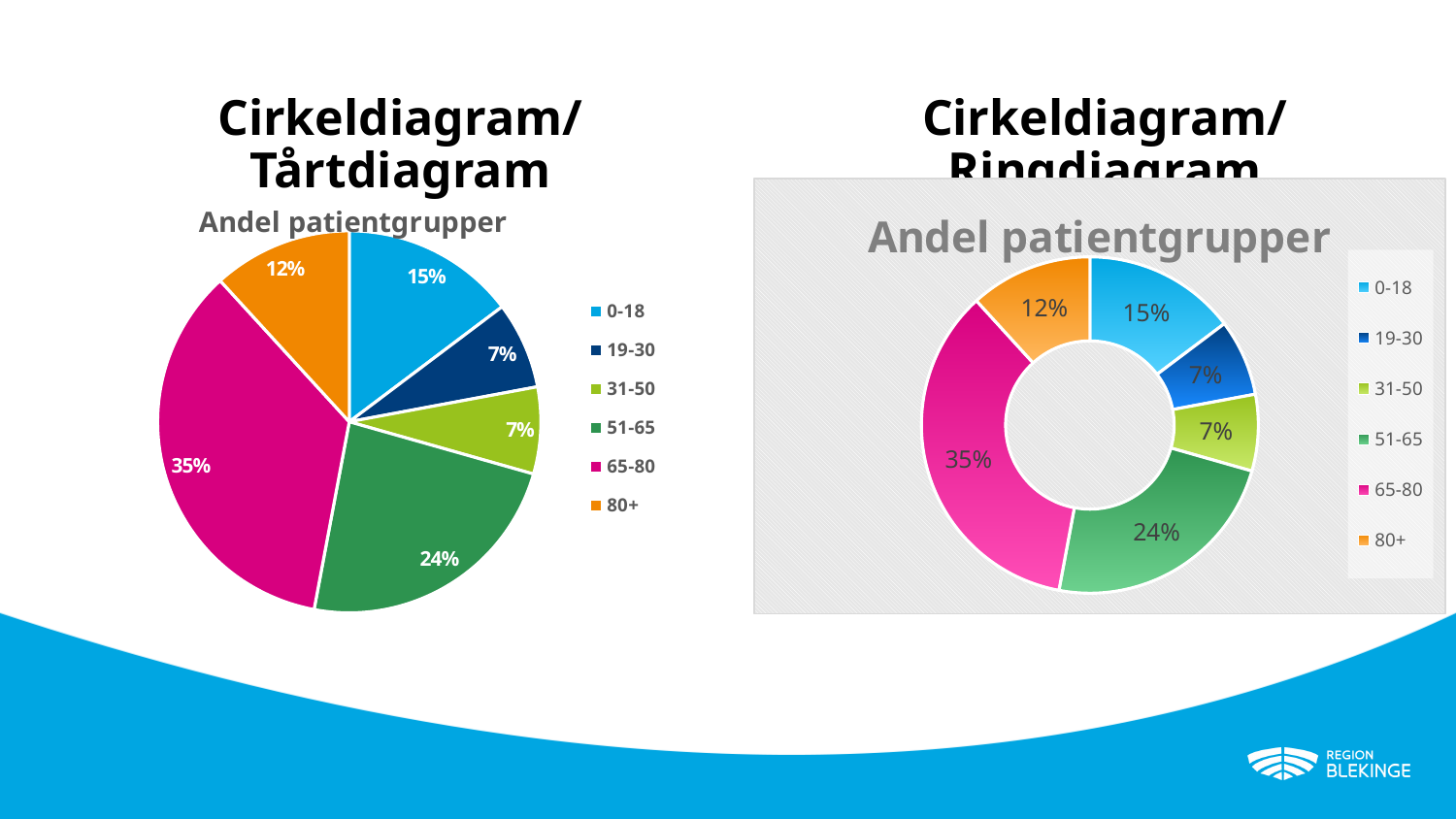
In the pie chart on the left, what is the difference in percentage points between the 65-80 group and the 51-65 group? 11 In the doughnut chart on the right, what share is shown for the 51-65 group? 24% How many entries does the legend of the doughnut chart on the right list? 6 In the doughnut chart on the right, what share is shown for the 80+ group? 12% How many patient groups are shown in the pie chart on the left? 6 In the pie chart on the left, what share is shown for the 0-18 group? 15% In the pie chart on the left, which patient group has the largest share? 65-80 In the doughnut chart on the right, which is larger, the share for 0-18 or the share for 80+? 0-18 In the pie chart on the left, what share is shown for the 65-80 group? 35% In the doughnut chart on the right, which patient group has the largest share? 65-80 What type of chart is shown on the right side of the slide? Doughnut chart What is the title of the pie chart on the left? Andel patientgrupper